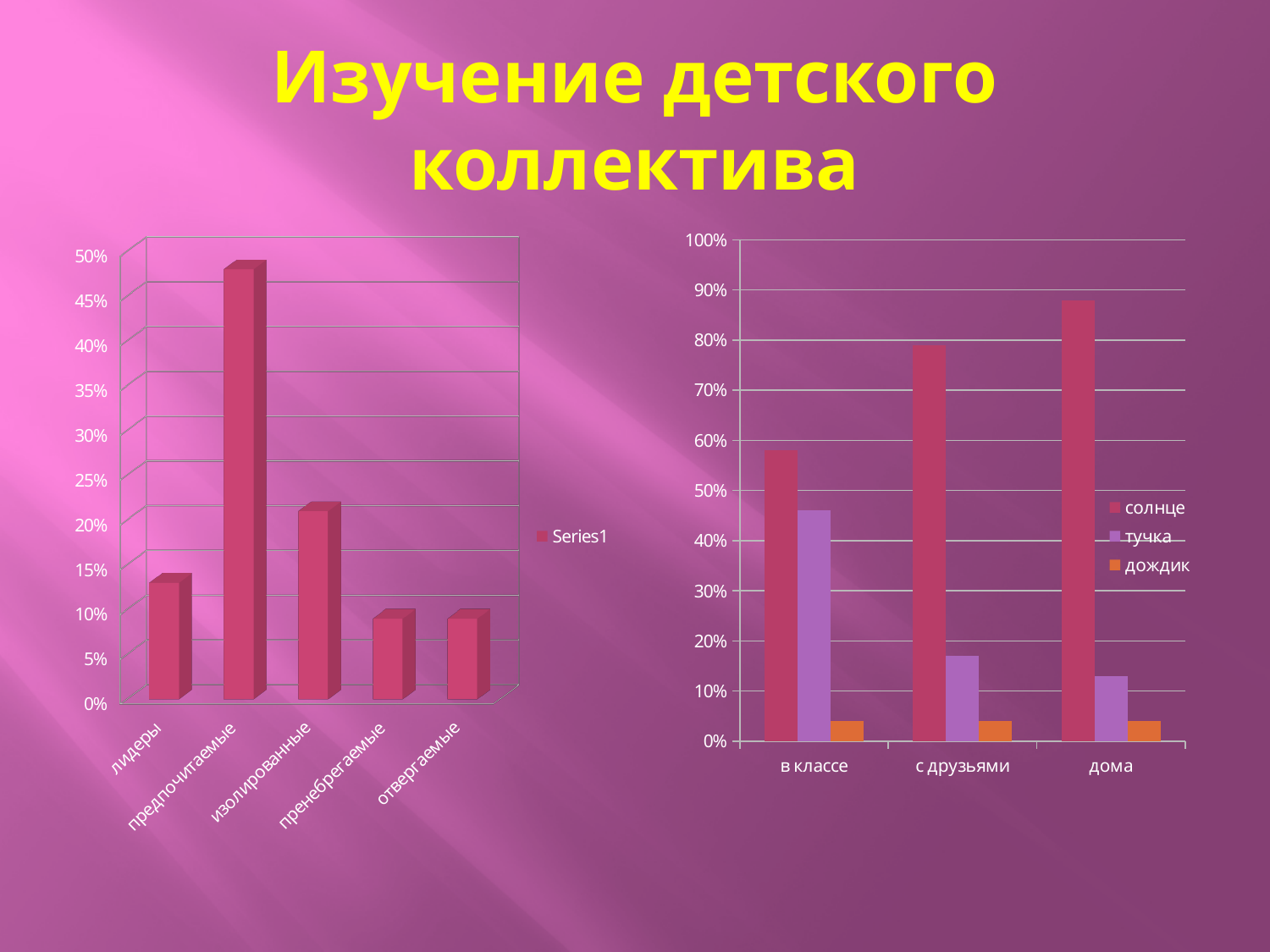
On the right chart, does the value for тучка rise or fall from в классе to дома? fall On the left chart, which category has the highest value? предпочитаемые What kind of chart is the right chart? bar chart On the right chart, is the value for тучка in в классе greater or less than 40%? greater On the left chart, is the value for предпочитаемые greater or less than 45%? greater On the right chart, how many series does the legend list? 3 On the right chart, is the value for солнце in с друзьями greater or less than 70%? greater On the left chart, which is larger, the value for лидеры or the value for изолированные? изолированные On the left chart, how many categories are shown on the x axis? 5 On the right chart, which category has the highest value for солнце? дома